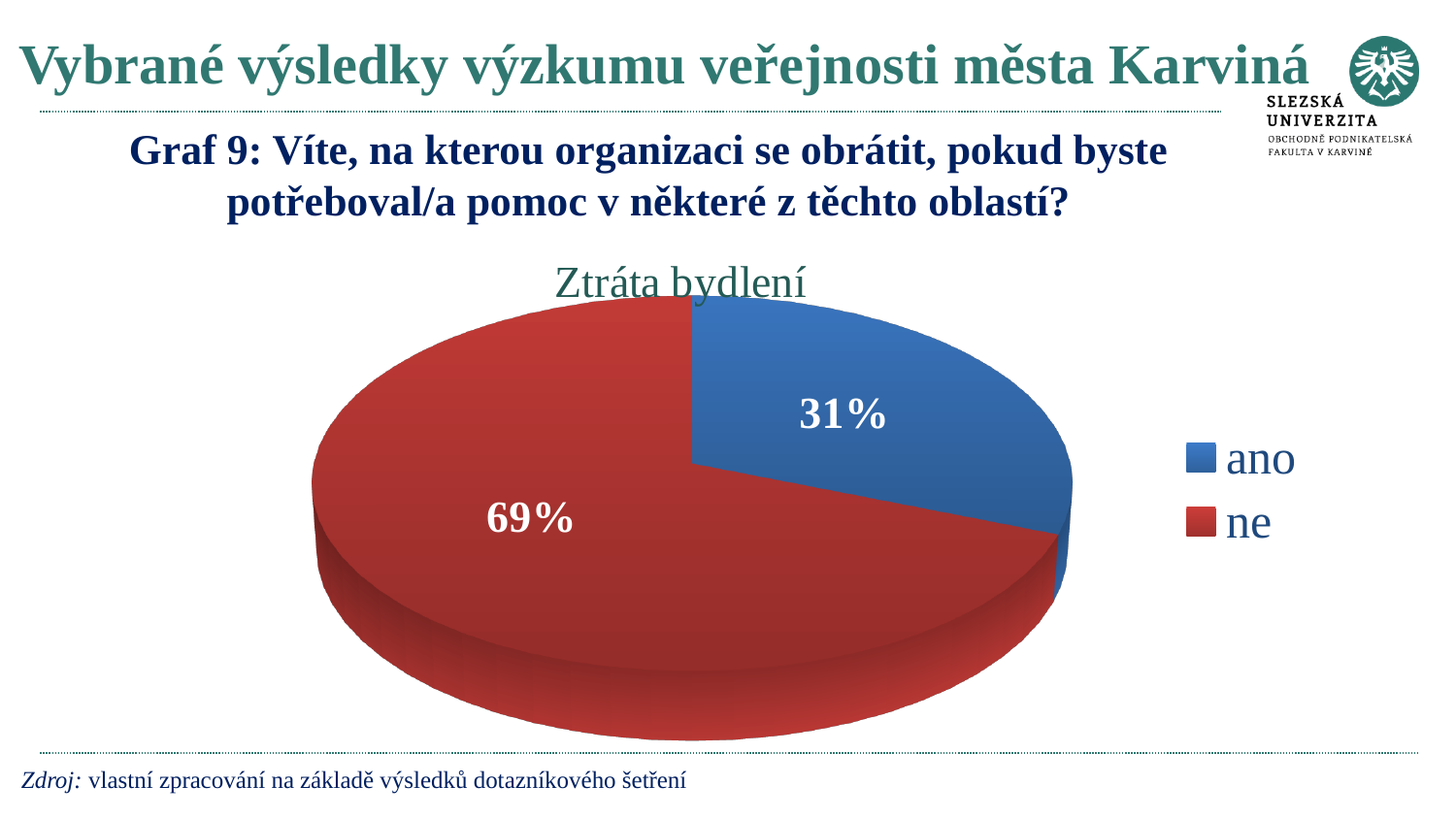
Which slice of the pie chart is the largest? ne Which is larger, the "ano" slice or the "ne" slice? ne Which slice of the pie chart is the smallest? ano How many entries does the legend list? 2 What is the total of the two slices shown in the pie chart? 100% What share of the pie chart is labelled "ne"? 69% What is the difference in percentage points between the "ne" and "ano" slices? 38 What colour is the "ne" slice in the pie chart? red What is the title of the pie chart? Ztráta bydlení What share of the pie chart is labelled "ano"? 31% What kind of chart is shown on the slide? pie chart How many slices does the pie chart have? 2